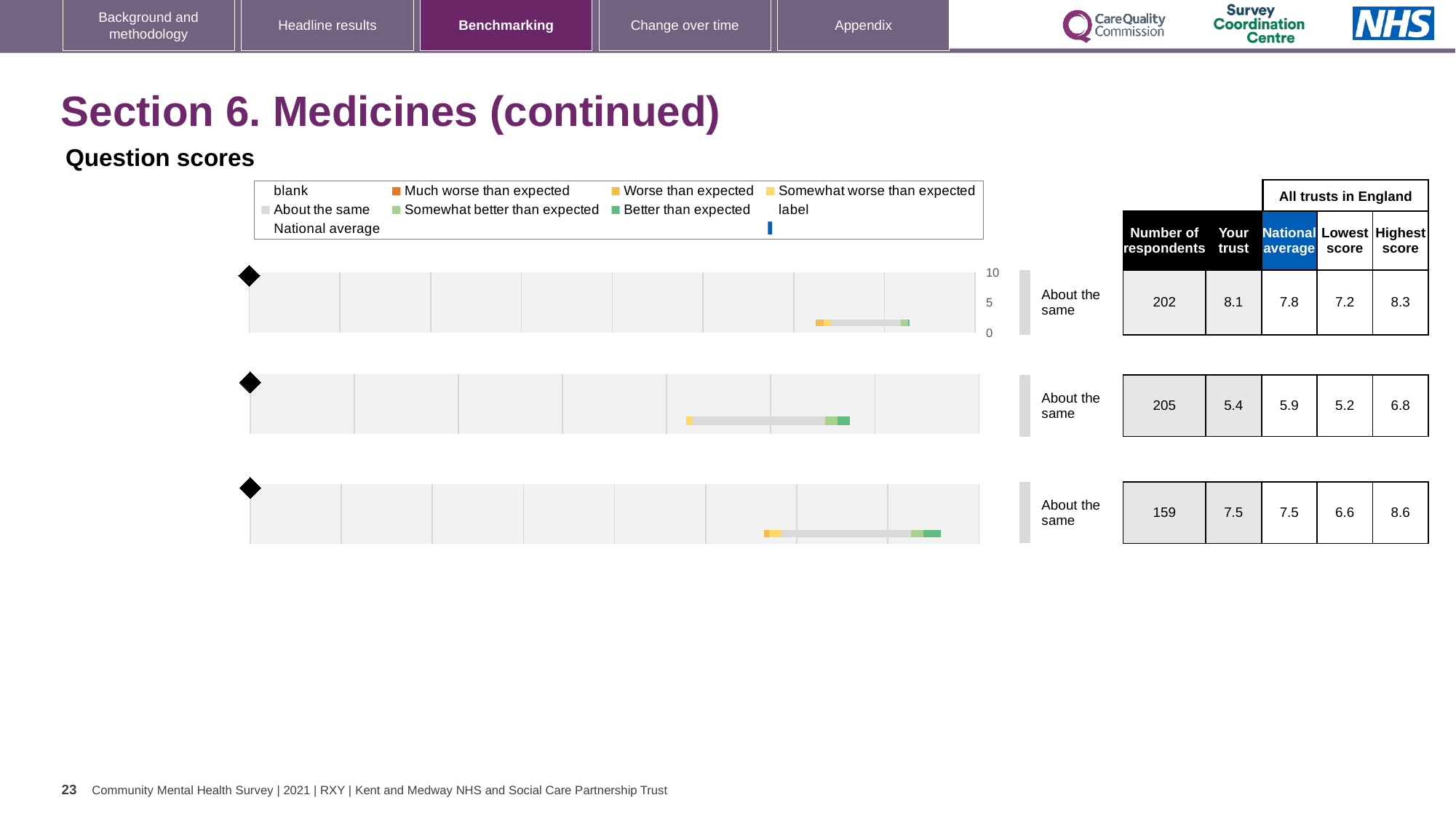
What is the maximum value shown on the score axis of the top chart? 10 For the top chart, what is the 'Your trust' score shown in the table? 8.1 Which of the three charts has the highest number of respondents? The middle chart (205) For the middle chart, what is the national average shown in the table? 5.9 How many charts (question rows) are shown on the slide? 3 For the middle chart, is the 'Your trust' score larger or smaller than the national average? Smaller For the top chart, what is the difference between the highest score and the lowest score across all trusts in England? 1.1 For the middle chart, what is the highest score among all trusts in England? 6.8 For the bottom chart, how many respondents are listed in the table? 159 For the bottom chart, is the 'Your trust' score greater or less than 5 on the axis? greater What benchmark category label is shown next to each of the three charts? About the same Which of the three charts has the lowest 'Your trust' score? The middle chart (5.4)